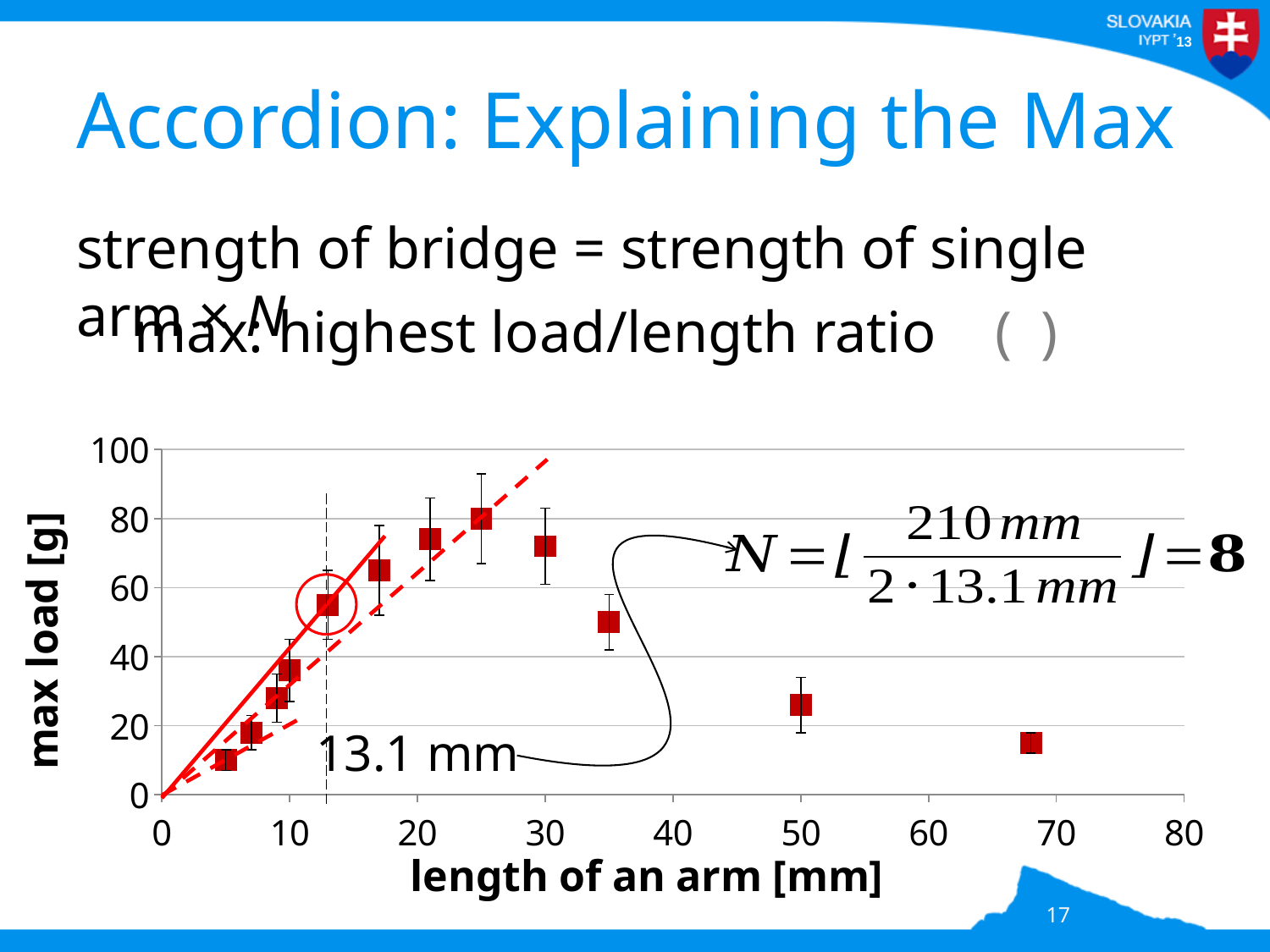
What arm length is marked by the dashed vertical line and annotation on the chart? 13.1 mm Is the max load for the point at about 25 mm arm length greater or less than 60 g? greater What is the label of the x axis of the chart? length of an arm [mm] What kind of chart is shown on the slide? scatter plot How does the max load change as the arm length increases beyond about 25 mm? it falls Is the max load for the point at about 35 mm arm length greater or less than 40 g? greater Which has the larger max load: the point at about 13 mm arm length or the point at about 50 mm arm length? the point at about 13 mm Which has the larger max load: the point at about 25 mm arm length or the point at about 68 mm arm length? the point at about 25 mm What is the label of the y axis of the chart? max load [g] Is the max load for the point at about 68 mm arm length greater or less than 20 g? less How many data points are plotted on the chart? 12